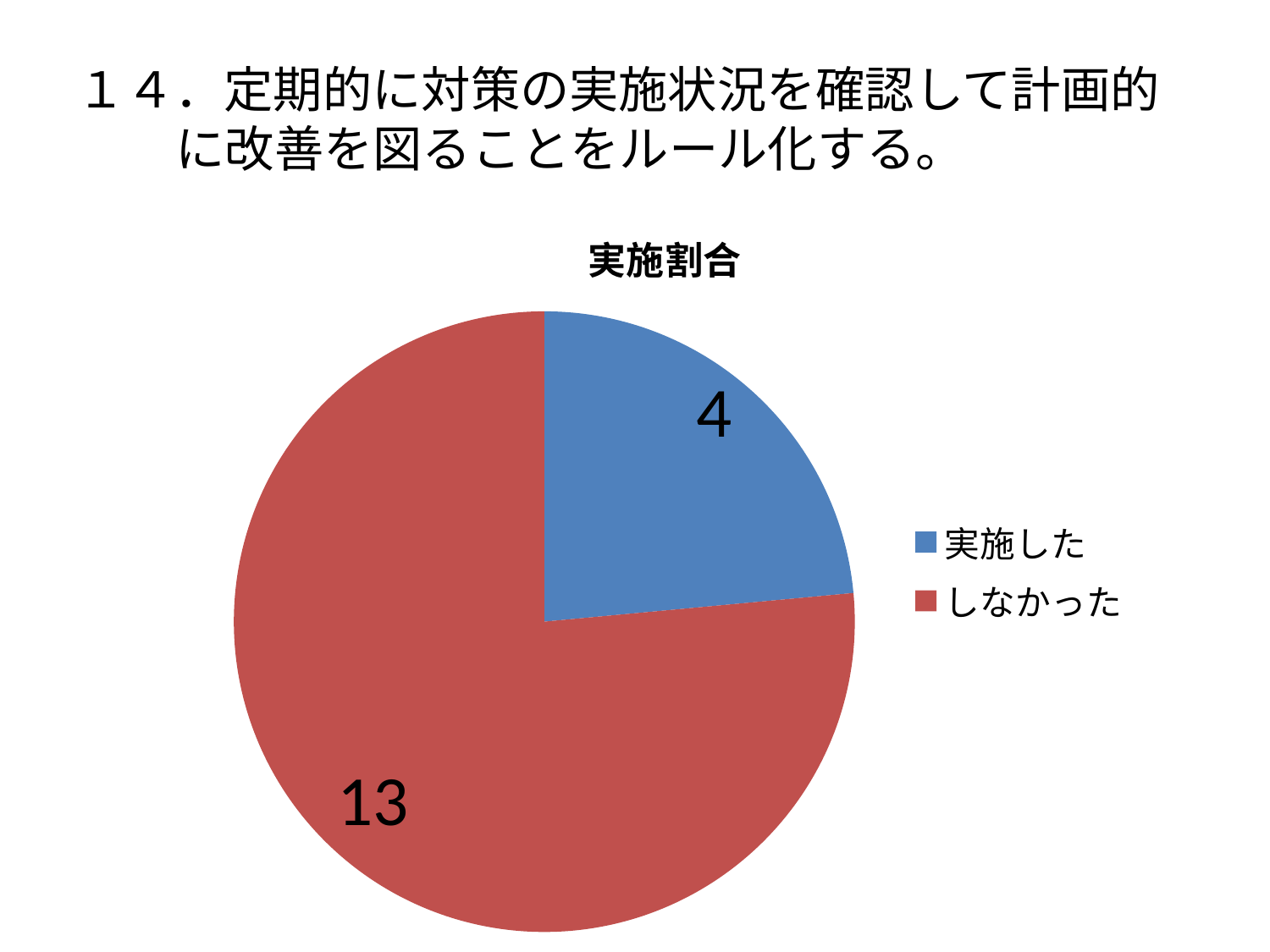
Which category has the smallest slice? 実施した What is the value for しなかった? 13 What is the value for 実施した? 4 What is the total of all slices in the pie chart? 17 Which is larger, the value for 実施した or the value for しなかった? しなかった What is the difference between the values for しなかった and 実施した? 9 Which category has the largest slice? しなかった What kind of chart is shown on the slide? pie chart What colour is the slice for しなかった? red How many slices does the pie chart have? 2 What is the title of the chart? 実施割合